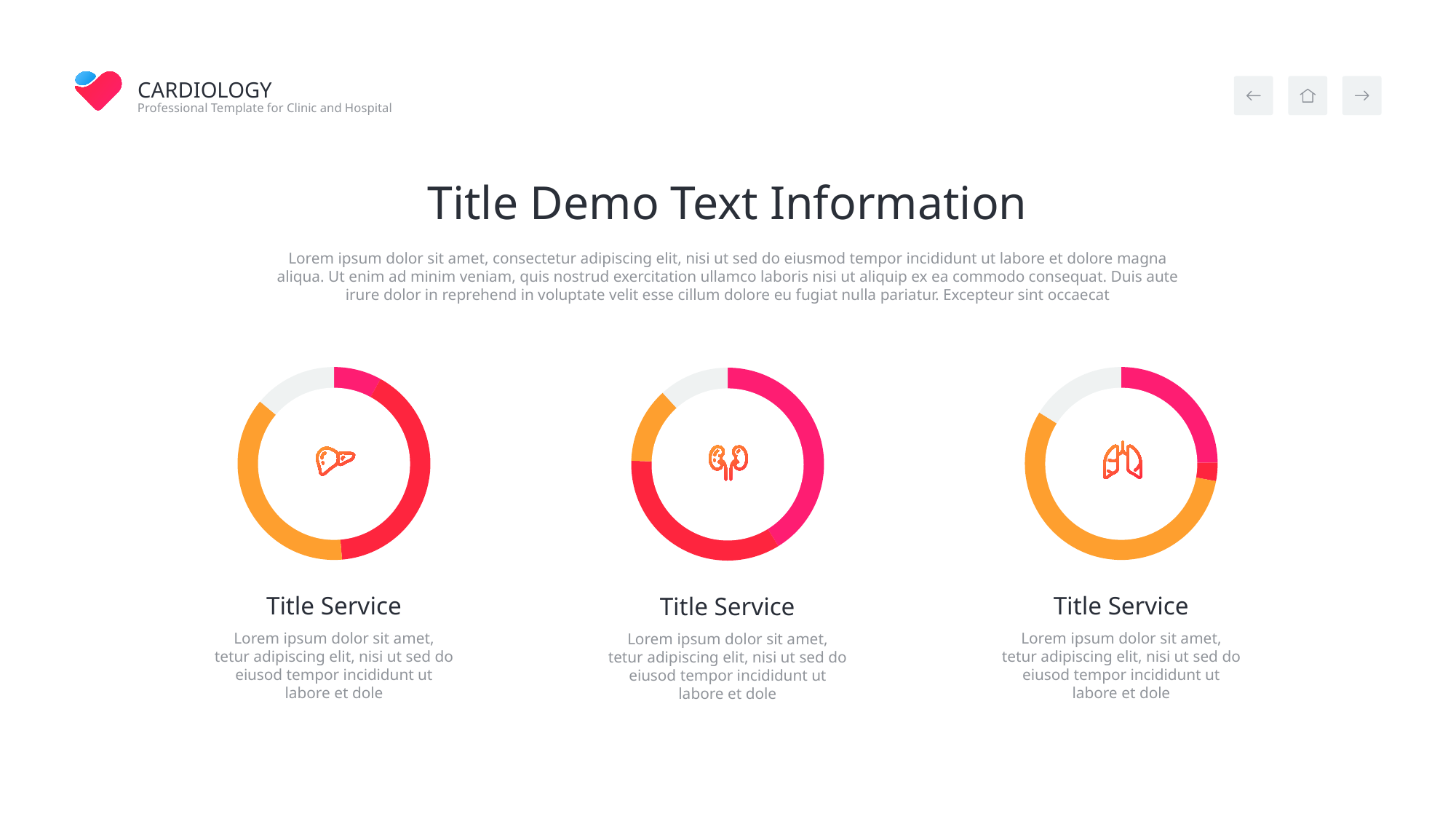
Does the middle doughnut chart (with the kidney icon) contain an orange segment? Yes In the middle doughnut chart (with the kidney icon), how many segments make up the ring? 4 In the middle doughnut chart (with the kidney icon), which colour segment is the largest? Pink In the left doughnut chart (with the liver icon), how many coloured segments make up the ring? 4 Does the right doughnut chart (with the lungs icon) contain a red segment? Yes How many doughnut charts are shown on the slide? 3 In the middle doughnut chart (with the kidney icon), is the pink segment larger or smaller than the red segment? Larger What kind of chart is shown on the left of the slide, above the first "Title Service" heading? Doughnut chart In the right doughnut chart (with the lungs icon), which colour segment is the largest? Orange In the right doughnut chart (with the lungs icon), is the orange segment larger or smaller than the pink segment? Larger In the right doughnut chart (with the lungs icon), which colour segment is the smallest? Red